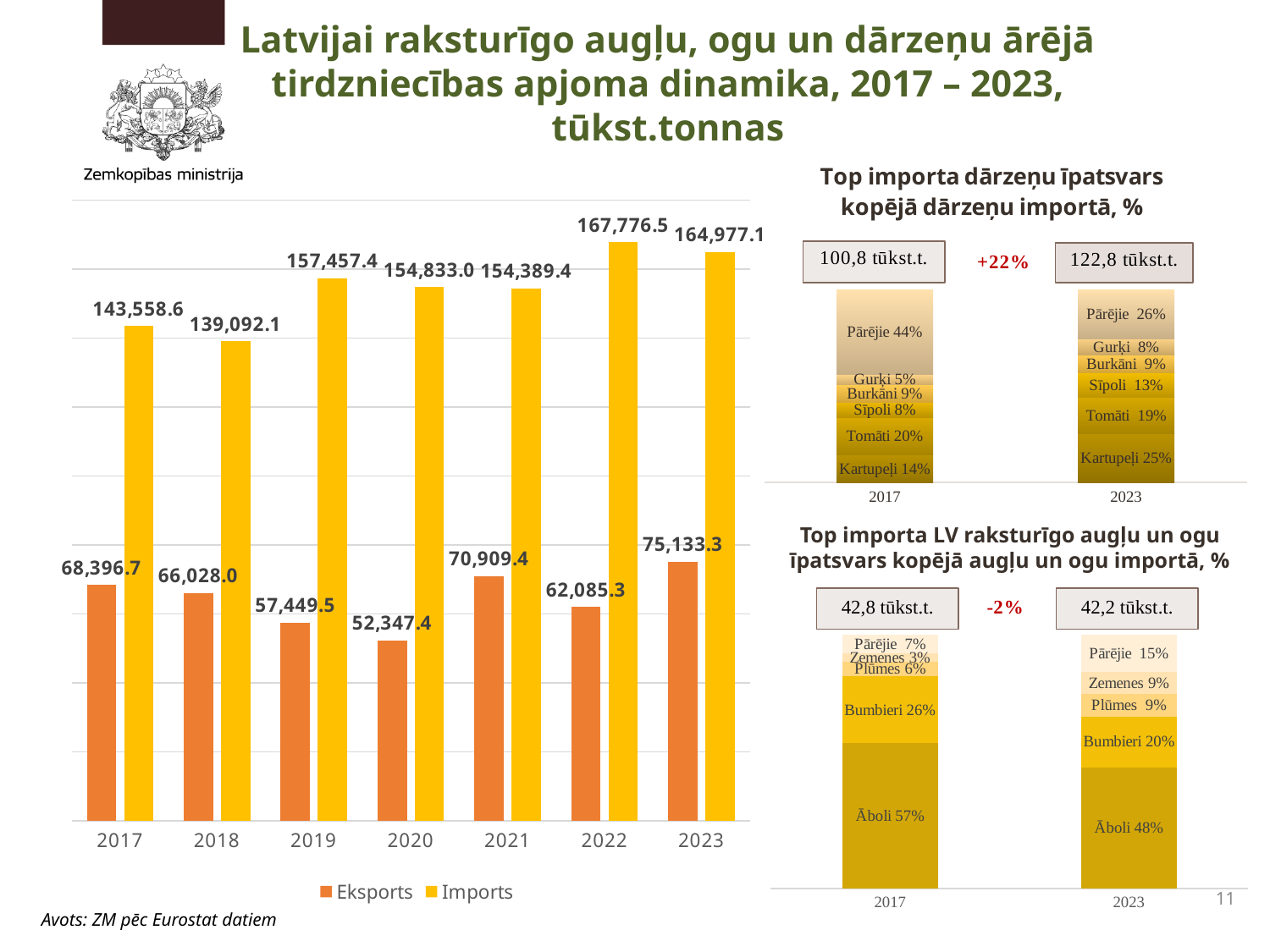
In the main bar chart on the left, what is the Imports value for 2022? 167,776.5 In the main bar chart on the left, which year has the highest Eksports value? 2023 In the main bar chart on the left, what is the difference between Imports and Eksports in 2023? 89,843.8 In the main bar chart on the left, how many years are shown on the x axis? 7 In the chart titled 'Top importa dārzeņu īpatsvars kopējā dārzeņu importā, %', what percentage change is shown between 2017 and 2023? +22% In the main bar chart on the left, how many series does the legend list? 2 What type of chart is the main chart on the left of the slide? bar chart In the chart titled 'Top importa LV raksturīgo augļu un ogu īpatsvars kopējā augļu un ogu importā, %', what is the share of Āboli in 2017? 57% In the main bar chart on the left, what is the Eksports value for 2020? 52,347.4 In the main bar chart on the left, which year has the lowest Imports value? 2018 In the main bar chart on the left, is the Eksports value for 2021 larger or smaller than the Eksports value for 2022? larger In the chart titled 'Top importa dārzeņu īpatsvars kopējā dārzeņu importā, %', what is the share of Kartupeļi in 2023? 25%